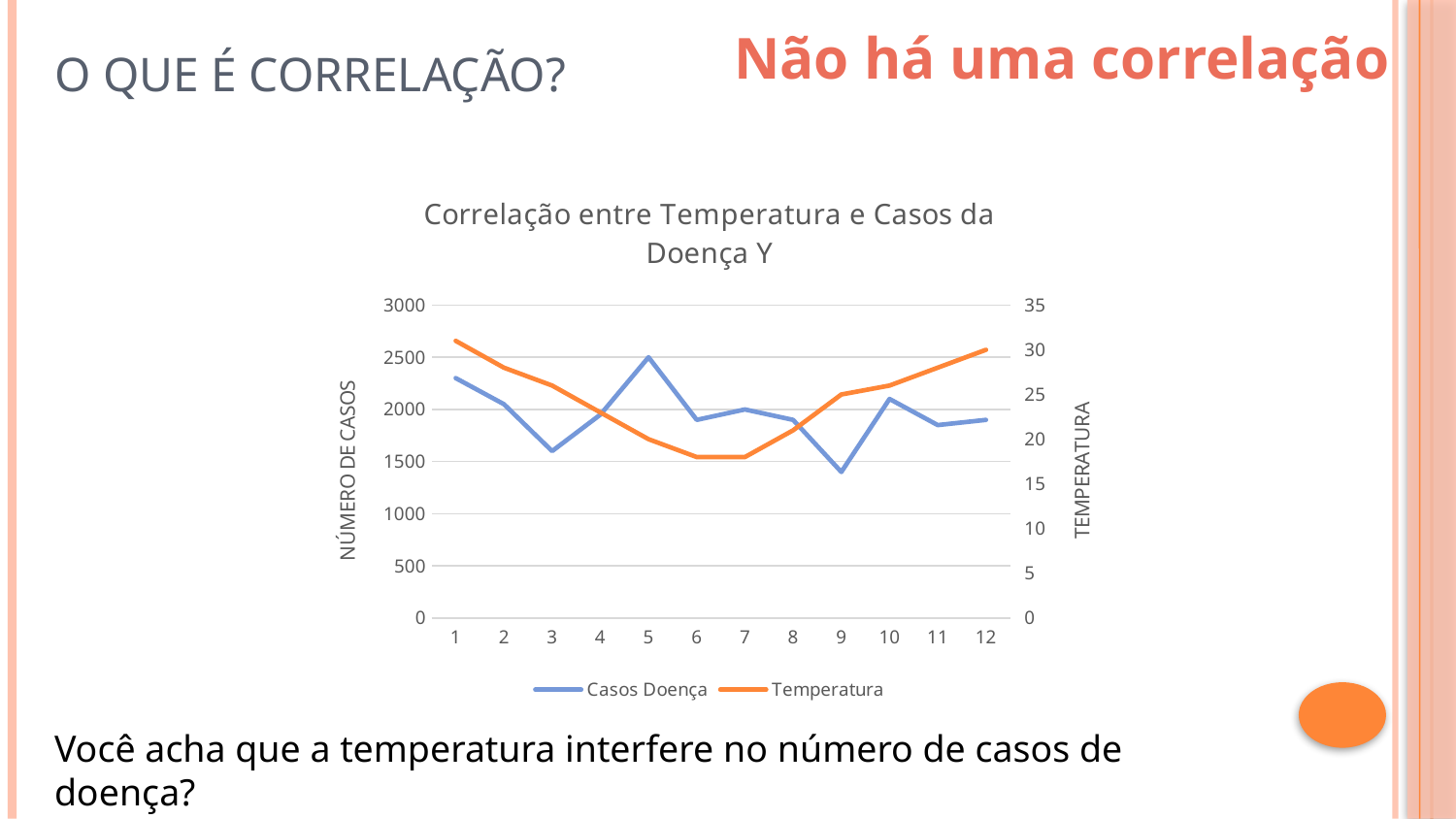
At which x-axis value does the Casos Doença series reach its highest point? 5 Is the Temperatura value at 6 greater or less than 20? less What is the title of the chart? Correlação entre Temperatura e Casos da Doença Y How many series does the legend list? 2 What kind of chart is shown on the slide? line chart Is the Casos Doença value at 5 greater or less than 2000? greater Which is larger for Temperatura: the value at 2 or the value at 8? 2 Which is larger for Casos Doença: the value at 1 or the value at 3? 1 Is the Casos Doença value at 9 greater or less than 1500? less At which x-axis value does the Casos Doença series reach its lowest point? 9 How many points are plotted along the x axis for each series? 12 Does the Temperatura series rise or fall from 1 to 6? fall